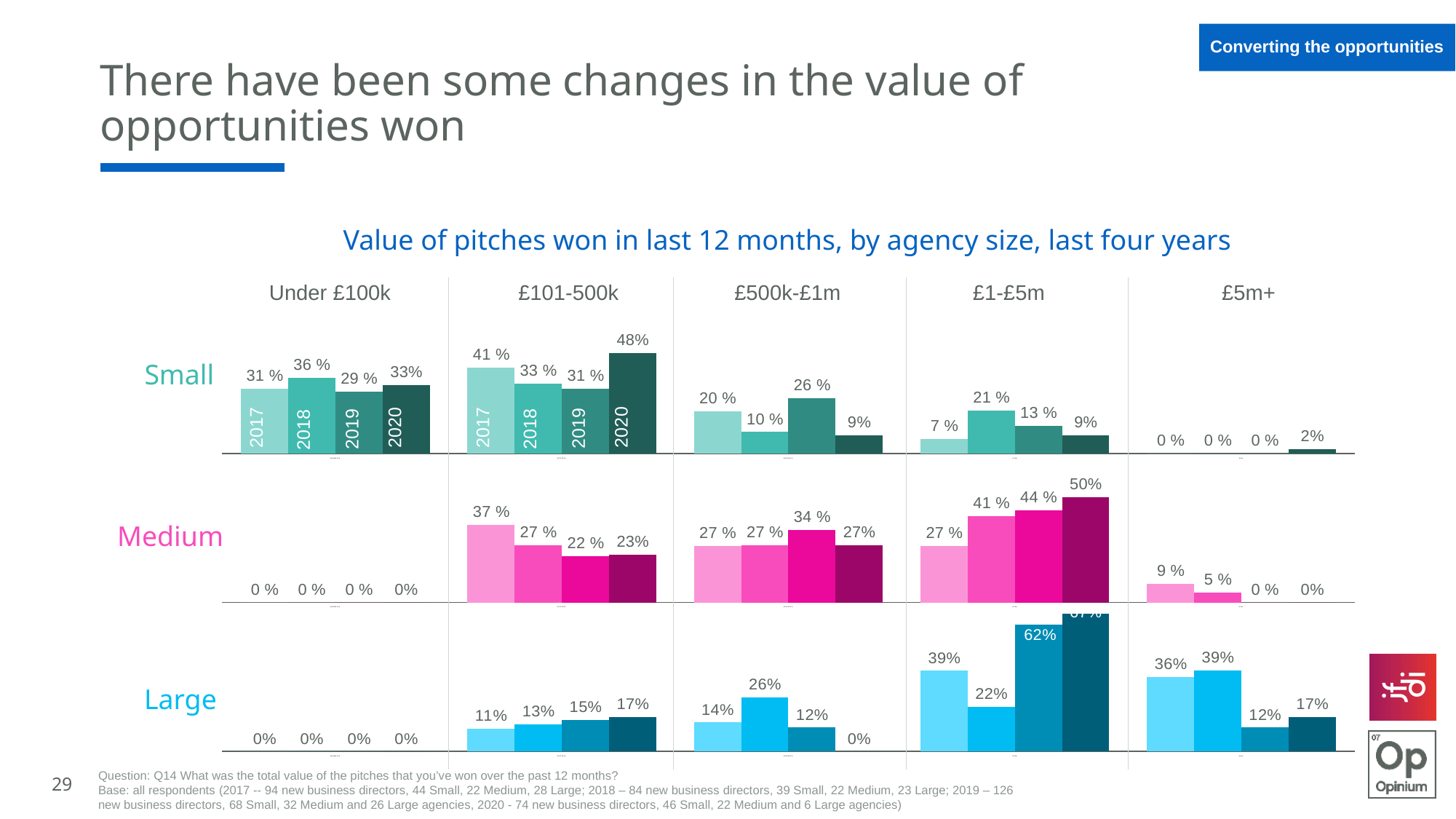
In the Large row, £1-£5m chart, which is larger, the value for 2017 or the value for 2018? 2017 In the Medium row, £1-£5m chart, what is the value for 2019? 44 % In the Medium row, £101-500k chart, which year has the lowest value? 2019 What kind of chart is used on the slide? bar chart In the Small row, £101-500k chart, what is the difference between the 2020 and 2019 values? 17 percentage points In the Large row, £101-500k chart, do the values rise or fall from 2017 to 2020? rise In the Small row, £500k-£1m chart, which year has the highest value? 2019 What is the title of the chart on the slide? Value of pitches won in last 12 months, by agency size, last four years In the Small row, £101-500k chart, what is the value for 2020? 48% How many years are plotted in each chart on the slide? 4 In the Large row, £5m+ chart, what is the value for 2017? 36% In the Medium row, Under £100k chart, what is the value for 2018? 0 %